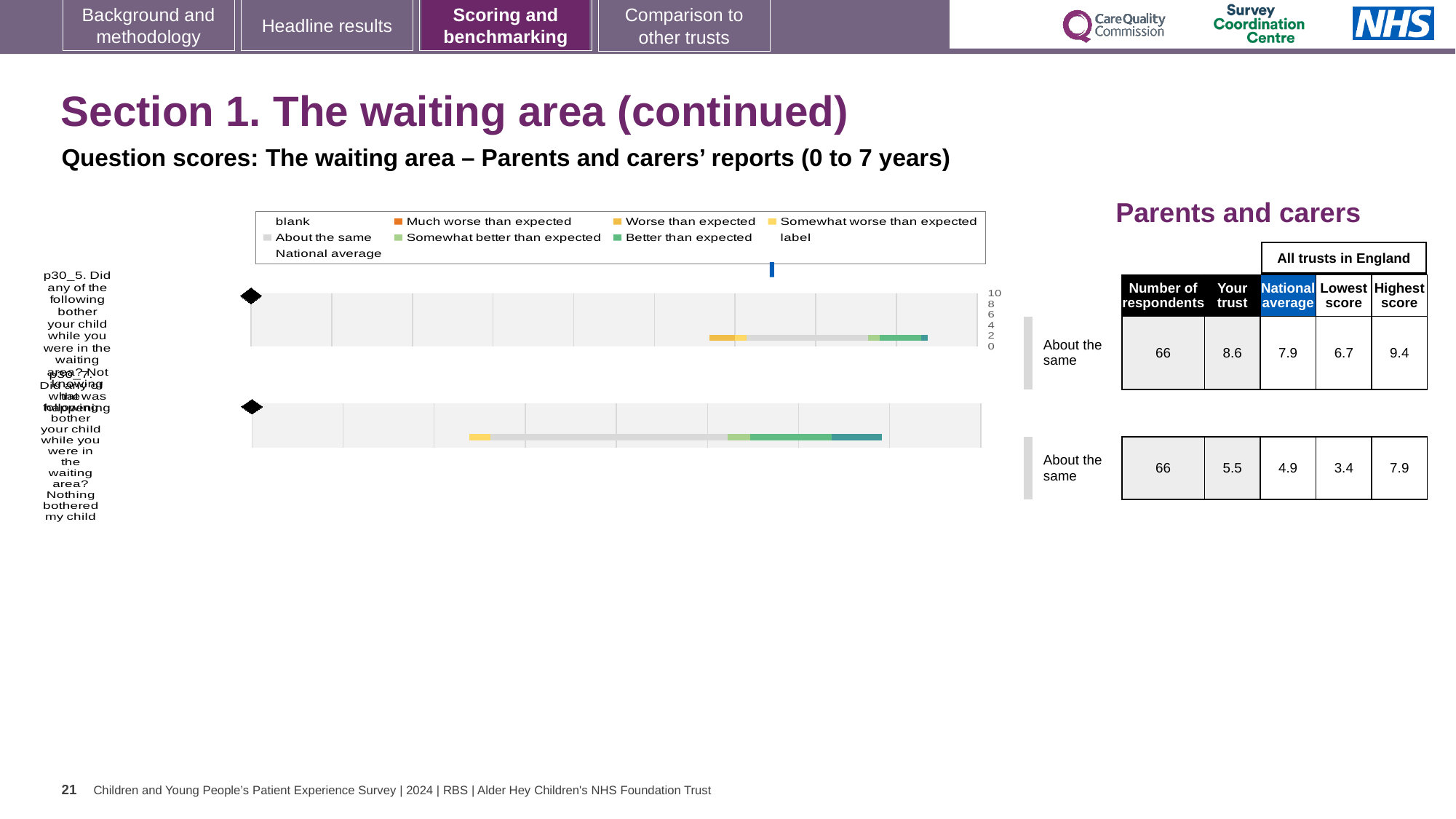
In the top chart (p30_5), which segment is longer: 'About the same' or 'Worse than expected'? About the same How many bars are plotted in the top chart (p30_5)? 1 What kind of chart is the top chart (p30_5)? bar chart How many entries does the legend above the charts list? 9 Which legend entry is shown in orange? Much worse than expected How many bars are plotted in the bottom chart (p30_7)? 1 What kind of chart is the bottom chart (p30_7)? bar chart Which legend entry is shown in grey? About the same In the bottom chart (p30_7), which segment is longer: 'Better than expected' or 'Somewhat better than expected'? Better than expected